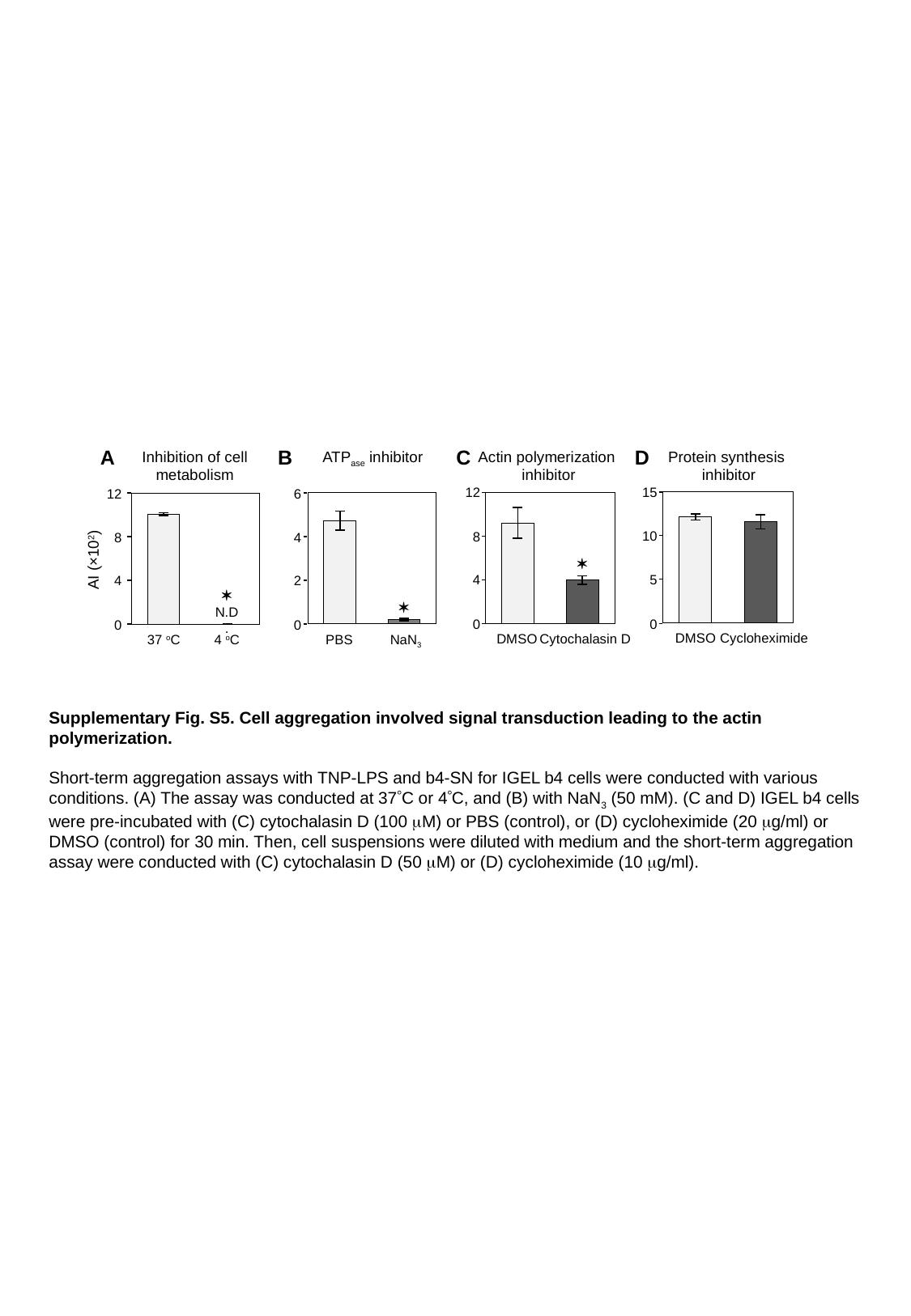
In chart B, "ATPase inhibitor", is the value for NaN3 greater or less than 2? less In chart C, "Actin polymerization inhibitor", which category has the lowest value? Cytochalasin D How many categories are shown on the x axis of chart B, "ATPase inhibitor"? 2 What kind of chart is chart A, "Inhibition of cell metabolism"? bar chart In chart D, "Protein synthesis inhibitor", is the value for Cycloheximide greater or less than 10? greater What is the y-axis label shown on chart A, "Inhibition of cell metabolism"? AI (×10²) In chart B, "ATPase inhibitor", is the value for PBS greater or less than 4? greater In chart A, "Inhibition of cell metabolism", what is shown for the 4 °C condition? N.D In chart B, "ATPase inhibitor", which category has the higher value, PBS or NaN3? PBS What is the title of chart D? Protein synthesis inhibitor